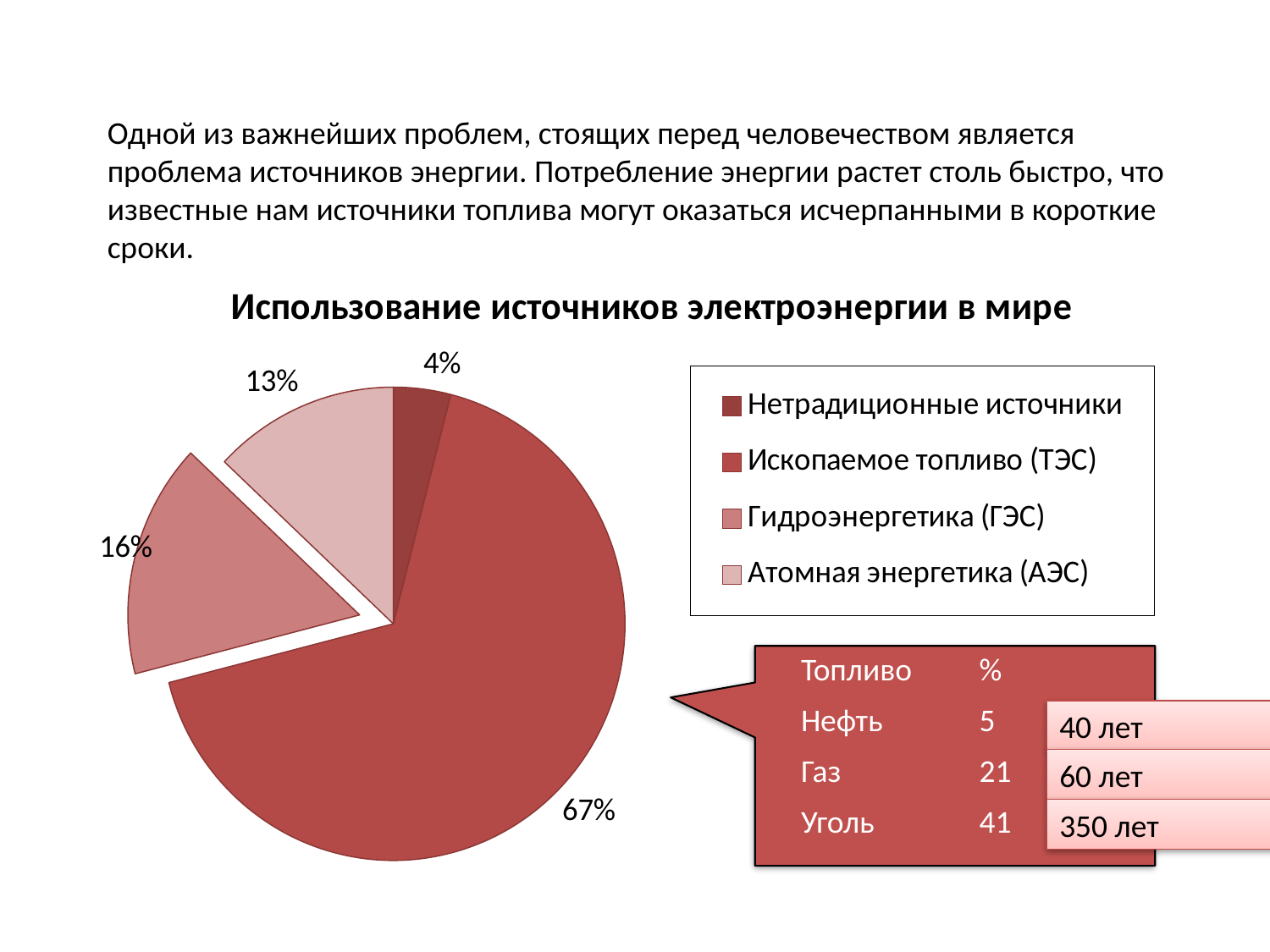
What share of the pie is Нетрадиционные источники? 4% Which is larger, the share for Гидроэнергетика (ГЭС) or the share for Атомная энергетика (АЭС)? Гидроэнергетика (ГЭС) What is the title of the chart? Использование источников электроэнергии в мире What kind of chart is shown on the slide? Pie chart What share of the pie is Гидроэнергетика (ГЭС)? 16% What is the difference in percentage points between the share for Ископаемое топливо (ТЭС) and the share for Гидроэнергетика (ГЭС)? 51 How many slices does the pie chart have? 4 Which energy source has the largest slice of the pie? Ископаемое топливо (ТЭС) What share of the pie is Ископаемое топливо (ТЭС)? 67% How many entries does the chart legend list? 4 Which energy source has the smallest slice of the pie? Нетрадиционные источники